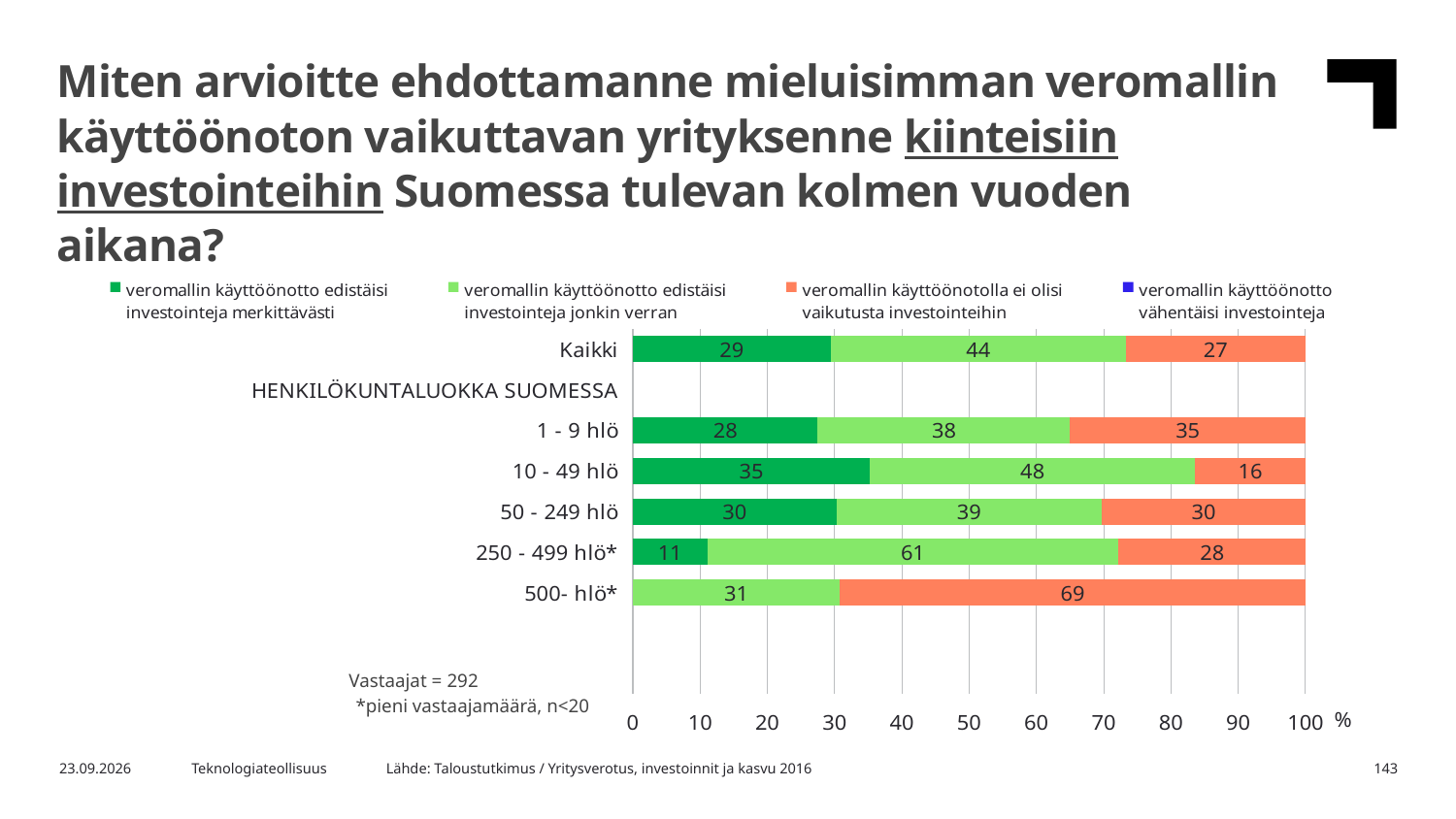
What is the total of the 10 - 49 hlö bar (35 + 48 + 16)? 99 What is the value for 'veromallin käyttöönotto edistäisi investointeja jonkin verran' in the 250 - 499 hlö* bar? 61 Which is larger: the 'veromallin käyttöönotolla ei olisi vaikutusta investointeihin' value for 1 - 9 hlö or for 50 - 249 hlö? 1 - 9 hlö How many categories (bars) are plotted in the chart? 6 Which category has the lowest value for 'veromallin käyttöönotolla ei olisi vaikutusta investointeihin'? 10 - 49 hlö What is the difference between the 'veromallin käyttöönotto edistäisi investointeja jonkin verran' values for 10 - 49 hlö and 1 - 9 hlö? 10 What is the value for 'veromallin käyttöönotto edistäisi investointeja merkittävästi' in the Kaikki bar? 29 How many series does the legend list? 4 What is the value for 'veromallin käyttöönotolla ei olisi vaikutusta investointeihin' in the 500- hlö* bar? 69 What is the number of respondents (Vastaajat) stated on the slide? 292 What kind of chart is shown on the slide? Stacked bar chart Which category has the highest value for 'veromallin käyttöönotto edistäisi investointeja merkittävästi'? 10 - 49 hlö